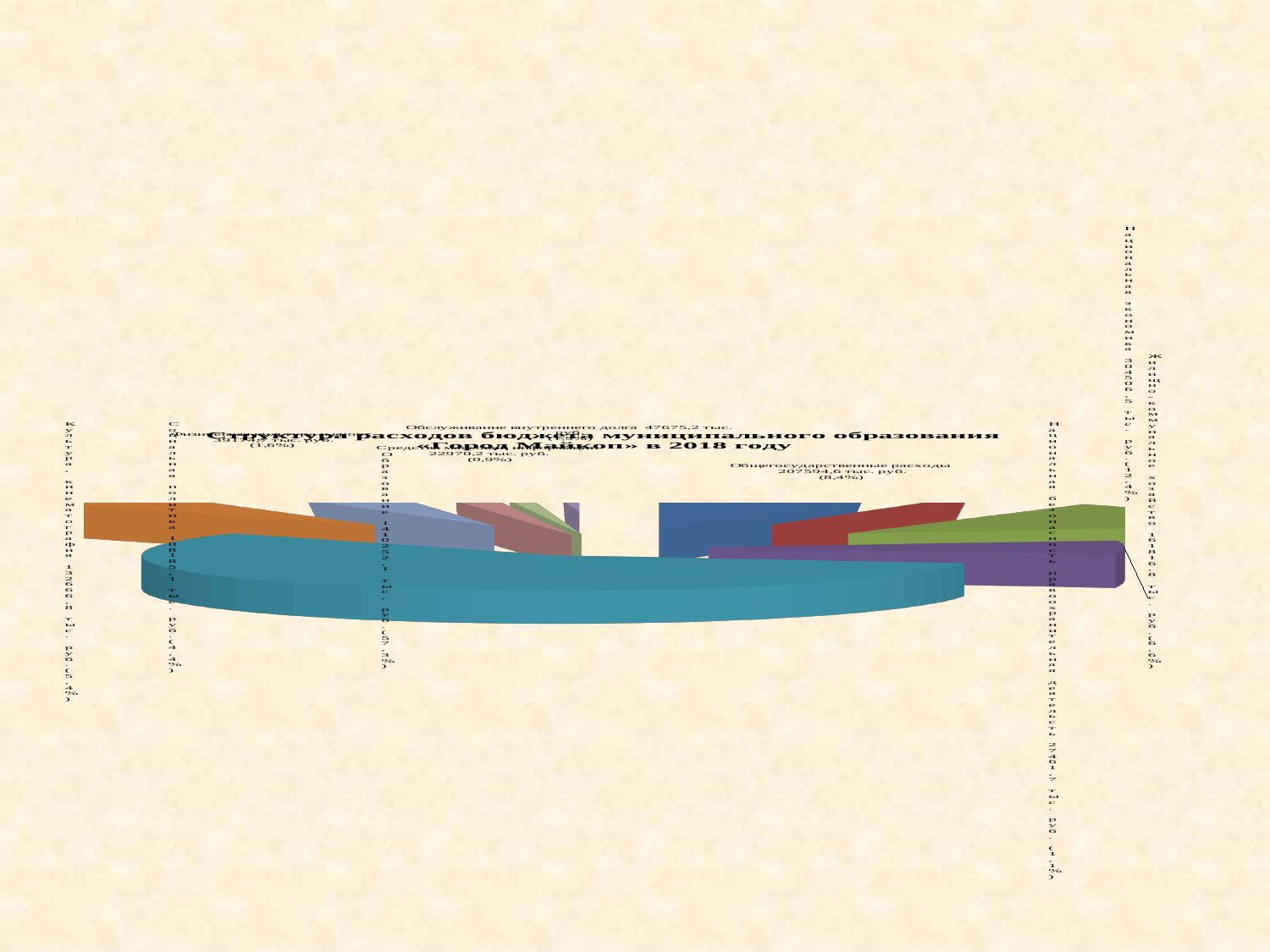
What share of the budget do Общегосударственные расходы account for? 8,4% What is the difference in share between Образование and Общегосударственные расходы? 48,9% What share of the budget does Жилищно-коммунальное хозяйство account for? 6,6% What share of the budget does Национальная экономика account for? 12,4% What is the value for Средства массовой информации? 22970,2 тыс. руб. Which expenditure category has the largest share of the budget? Образование What kind of chart is shown on the slide? Pie chart Which has the larger share: Общегосударственные расходы or Национальная экономика? Национальная экономика Which expenditure category has the smallest share of the budget? Средства массовой информации What is the value for Общегосударственные расходы? 207594,6 тыс. руб. What is the title of the chart? Структура расходов бюджета муниципального образования «Город Майкоп» в 2018 году